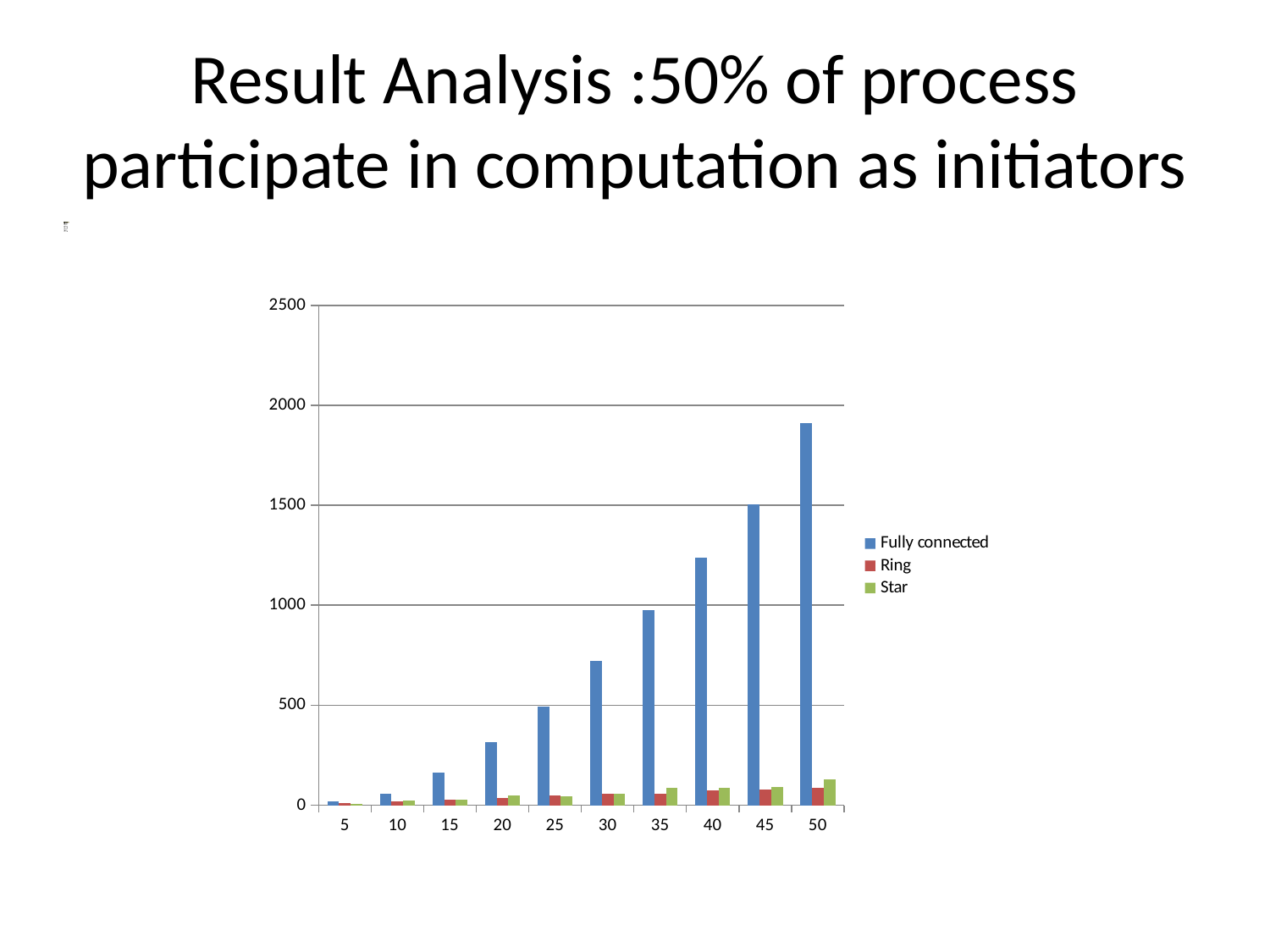
Do the Fully connected values rise or fall as the x-axis values increase from 5 to 50? rise At which x-axis category is the Fully connected series highest? 50 Is the Fully connected value at 50 greater or less than 1500? greater At which x-axis category is the Fully connected series lowest? 5 How many series does the legend list? 3 How many categories are shown along the x axis? 10 Is the Fully connected value at 30 greater or less than 500? greater At 50, which is larger: the Fully connected value or the Ring value? Fully connected Which series is shown in blue in the legend? Fully connected Is the Fully connected value at 20 greater or less than 500? less What kind of chart is shown on the slide? bar chart